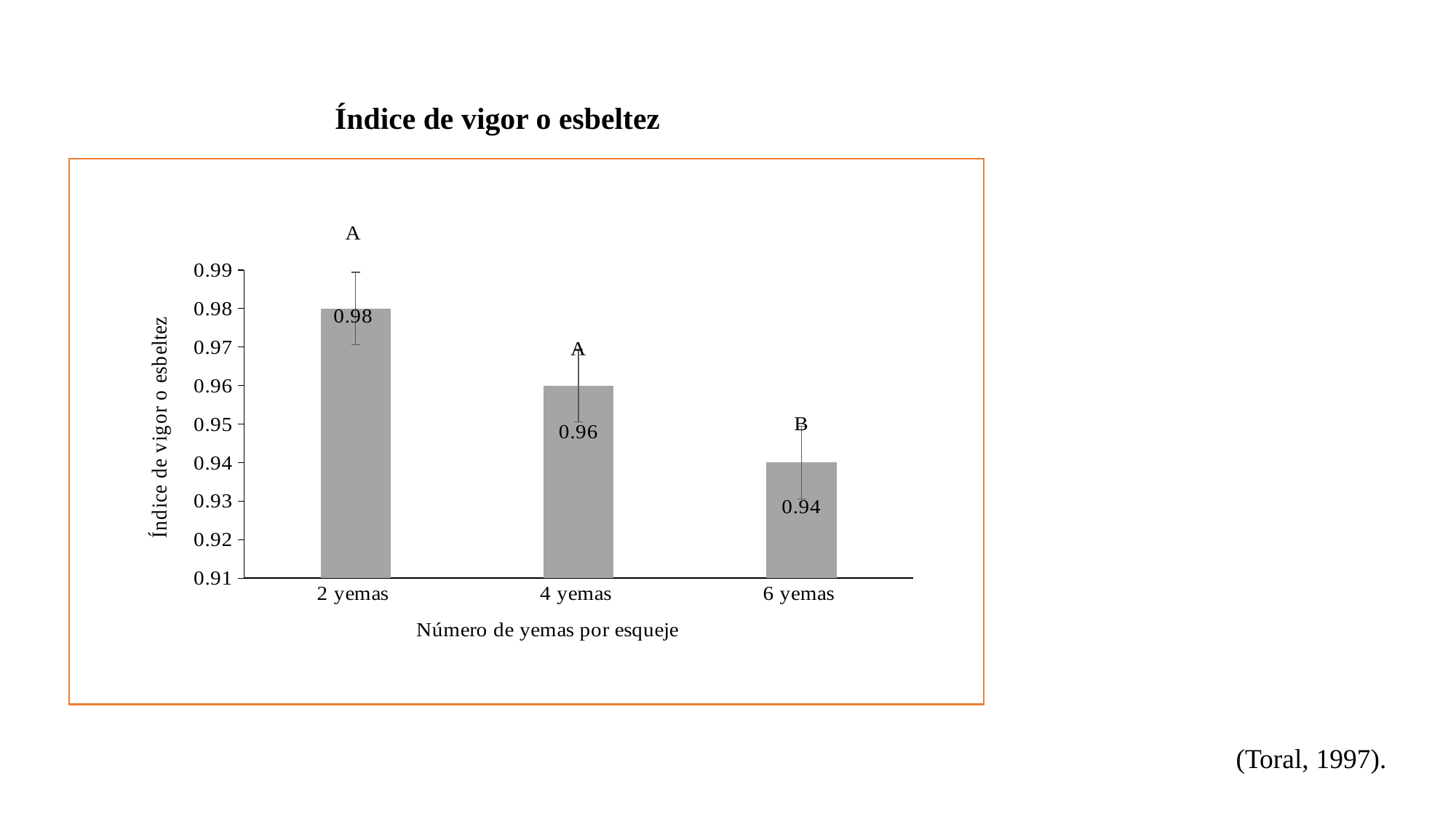
What is the value for 6 yemas? 0.94 Which category has the highest value? 2 yemas What is the value for 4 yemas? 0.96 What kind of chart is this? bar chart What is the difference between the values for 2 yemas and 6 yemas? 0.04 Do the values rise or fall as the number of yemas increases along the x axis? fall Which is larger, the value for 2 yemas or the value for 4 yemas? 2 yemas What is the title of the chart? Índice de vigor o esbeltez How many categories are shown on the x axis? 3 What is the value for 2 yemas? 0.98 Which category has the lowest value? 6 yemas What is the difference between the values for 4 yemas and 6 yemas? 0.02